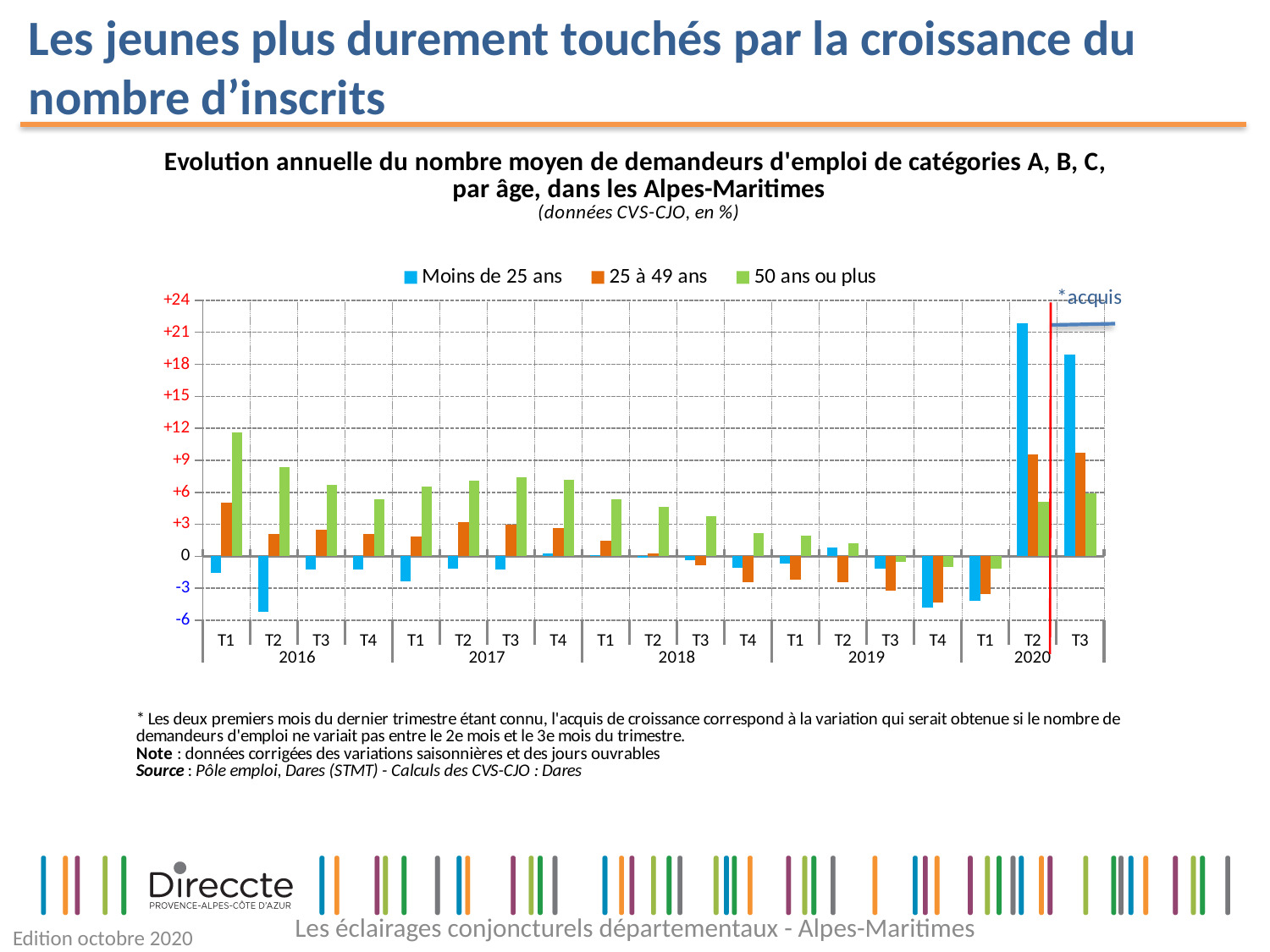
Is the value for '50 ans ou plus' in T1 2016 greater or less than +9? greater How many series does the legend list? 3 How many quarters are plotted along the x axis? 19 Which colour represents the 'Moins de 25 ans' series? blue In which quarter is the value for 'Moins de 25 ans' highest? T2 2020 Is the value for 'Moins de 25 ans' in T2 2016 greater or less than -3? less In T2 2020, which is larger: the value for 'Moins de 25 ans' or for '25 à 49 ans'? Moins de 25 ans In which quarter is the value for '50 ans ou plus' highest? T1 2016 In T1 2016, which is larger: the value for '50 ans ou plus' or for '25 à 49 ans'? 50 ans ou plus Is the value for '25 à 49 ans' in T3 2020 greater or less than +6? greater What kind of chart is shown on the slide? bar chart